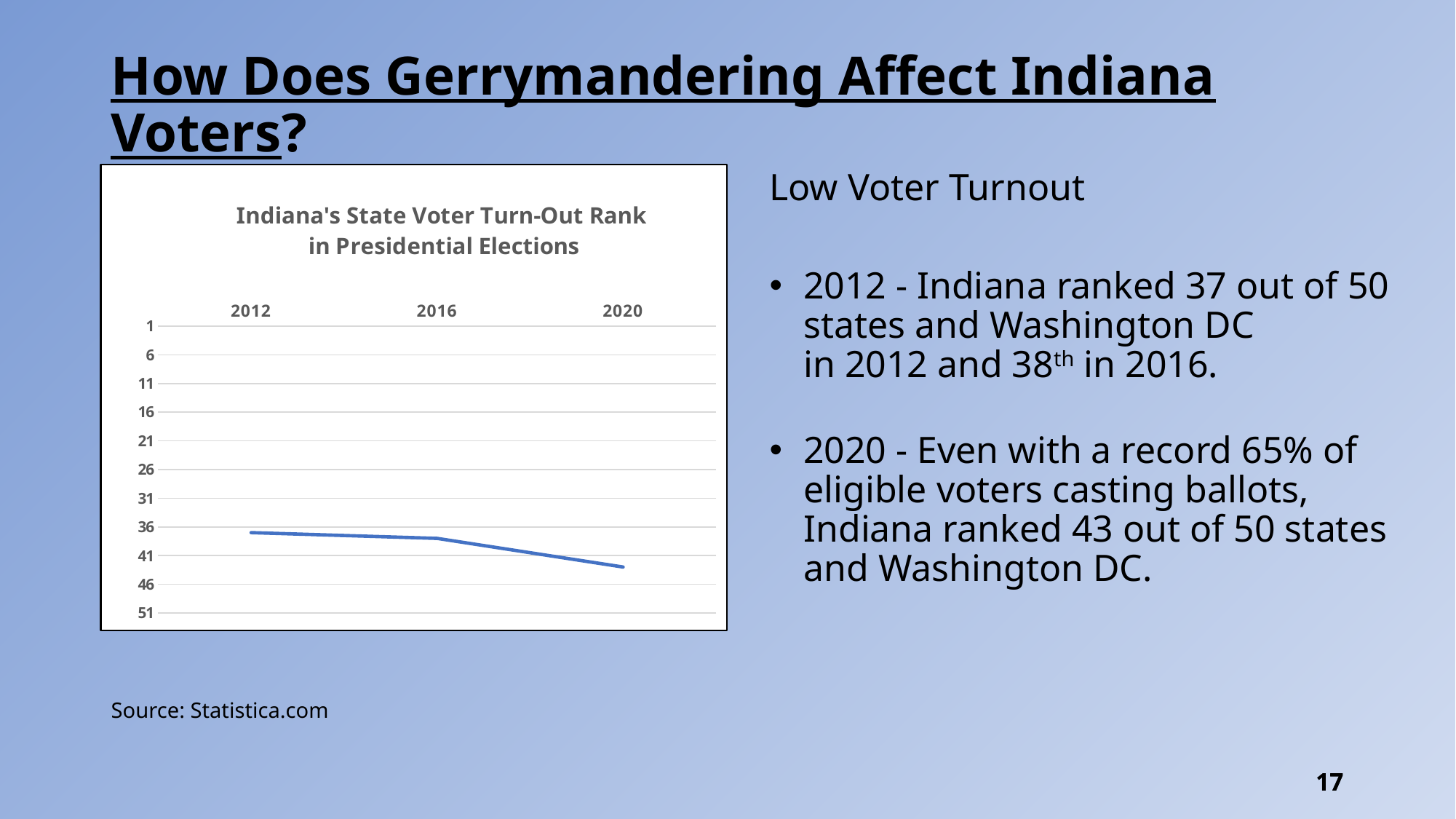
What is the title of the chart? Indiana's State Voter Turn-Out Rank in Presidential Elections What kind of chart is shown on the slide? line chart Do the plotted rank numbers increase or decrease from 2012 to 2020? increase How many data points are plotted on the line? 3 Is the plotted rank value for 2020 greater or less than 41? greater Which year has the highest plotted rank number on the chart? 2020 Which year has the larger plotted rank number, 2012 or 2020? 2020 Is the plotted rank value for 2016 greater or less than 41? less Is the plotted rank value for 2012 greater or less than 41? less Which years are shown on the x axis of the chart? 2012, 2016, 2020